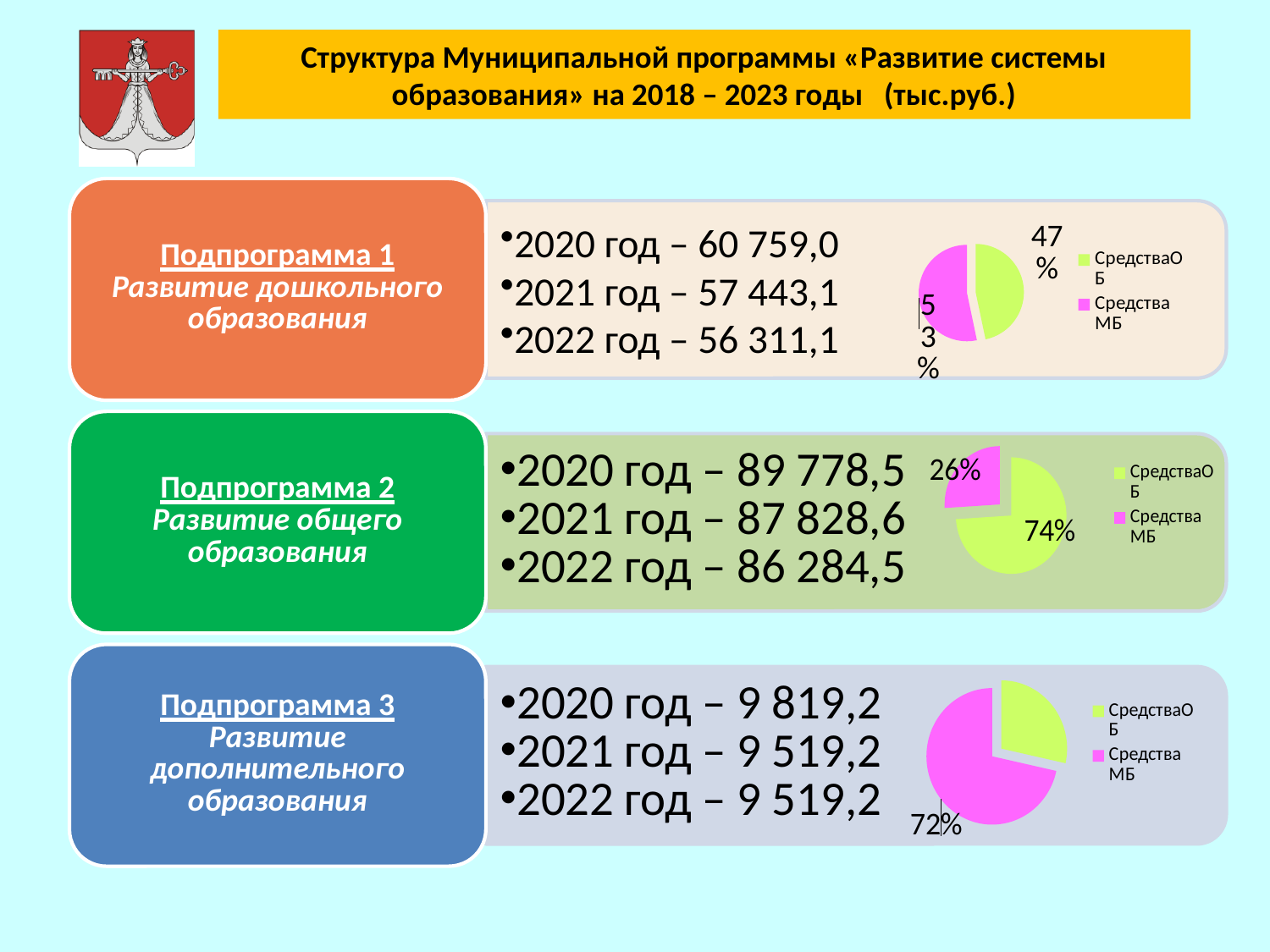
In the top pie chart (Подпрограмма 1), what share is labelled for Средства МБ? 53% In the bottom pie chart (Подпрограмма 3), which slice is the smallest? Средства ОБ In the middle pie chart (Подпрограмма 2), which slice is the largest? Средства ОБ In the top pie chart (Подпрограмма 1), what share is labelled for Средства ОБ? 47% In the middle pie chart (Подпрограмма 2), what share is labelled for Средства МБ? 26% In the middle pie chart (Подпрограмма 2), what is the difference between the Средства ОБ and Средства МБ shares? 48% How many slices does the bottom pie chart (Подпрограмма 3) have? 2 In the top pie chart (Подпрограмма 1), which slice is larger, Средства ОБ or Средства МБ? Средства МБ What type of chart is shown next to Подпрограмма 1 (top chart)? pie chart How many entries does the legend of the top pie chart (Подпрограмма 1) list? 2